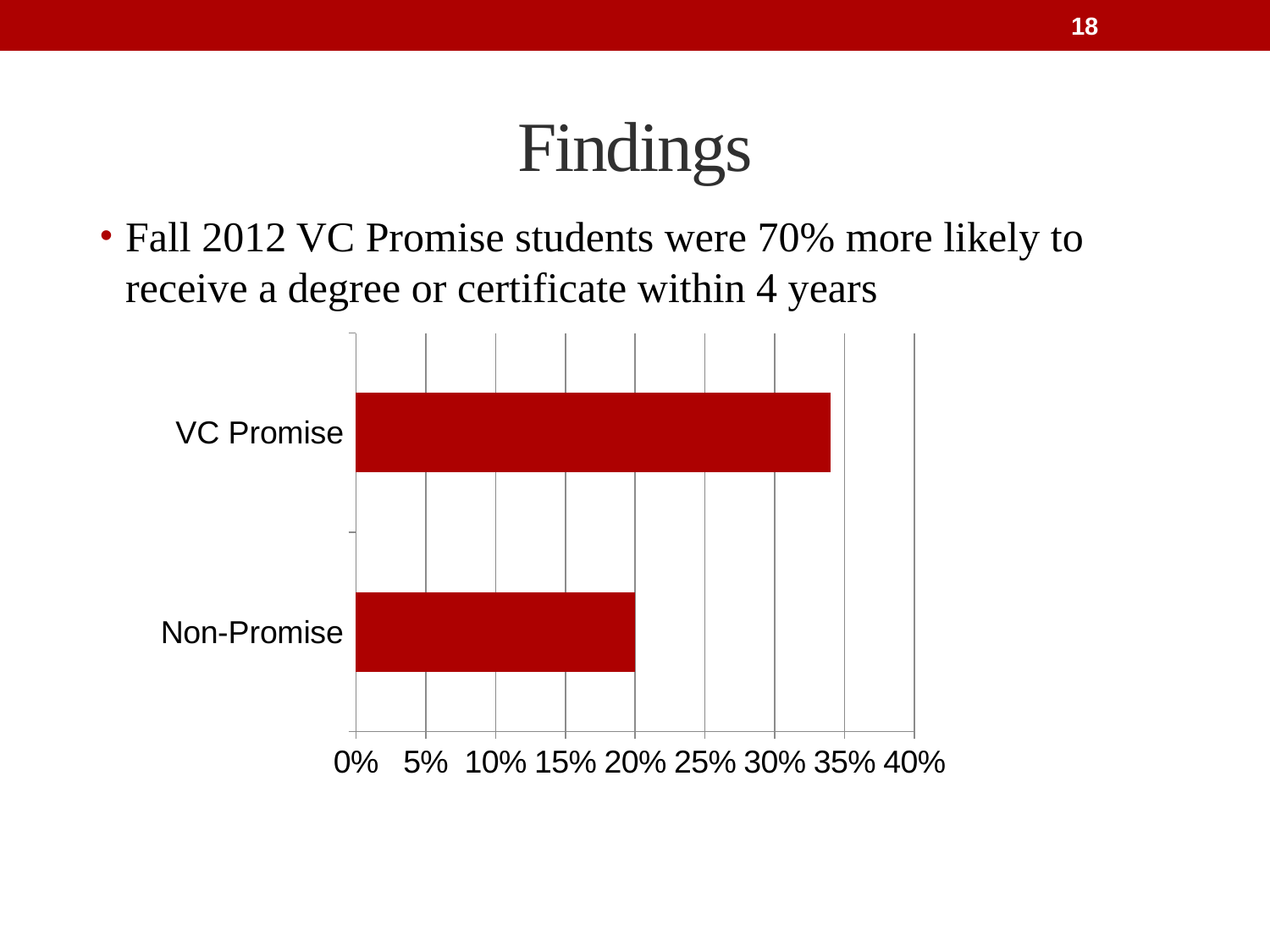
How many categories are plotted in the chart? 2 What colour are the bars in the chart? dark red Which category has the lowest value in the chart? Non-Promise Is the value for Non-Promise greater or less than 25%? less Which is larger, the value for VC Promise or the value for Non-Promise? VC Promise What is the value for Non-Promise in the chart? 20% Which category has the highest value in the chart? VC Promise What is the highest value shown on the chart's horizontal axis? 40% What kind of chart is shown on the slide? bar chart Is the value for VC Promise greater or less than 30%? greater Is the value for VC Promise greater or less than 35%? less